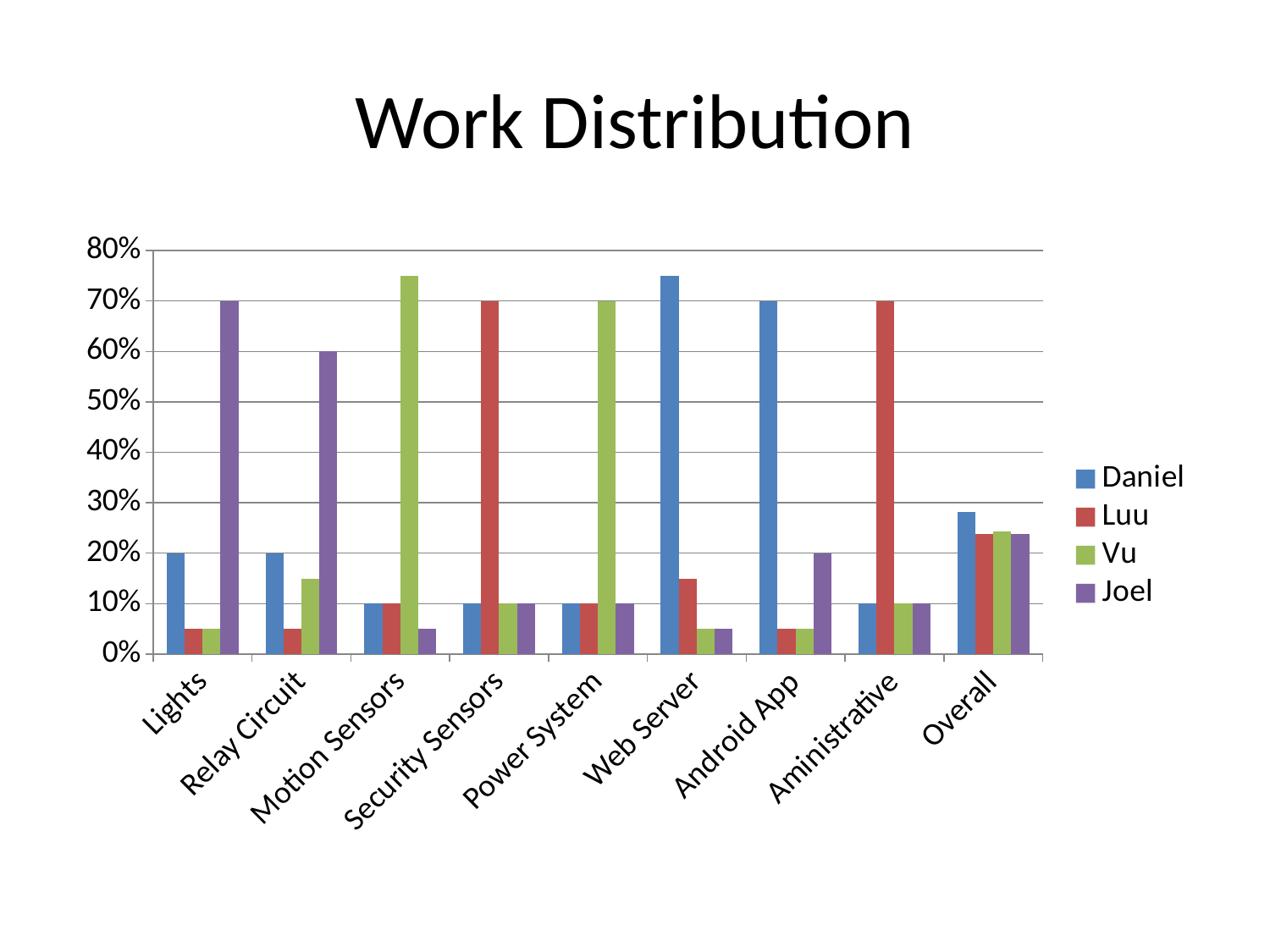
Which series has the highest value in the Power System category? Vu What is the value for Joel in the Lights category? 70% How many series does the legend list? 4 Is the value for Vu in the Motion Sensors category greater or less than 70%? greater What is the difference between Joel's and Daniel's values in the Lights category? 50% Is the value for Daniel in the Overall category greater or less than 30%? less What is the value for Daniel in the Android App category? 70% How many categories are shown on the x axis? 9 Which series has the highest value in the Web Server category? Daniel What is the value for Luu in the Security Sensors category? 70% What kind of chart is shown on the slide? bar chart What is the value for Joel in the Relay Circuit category? 60%